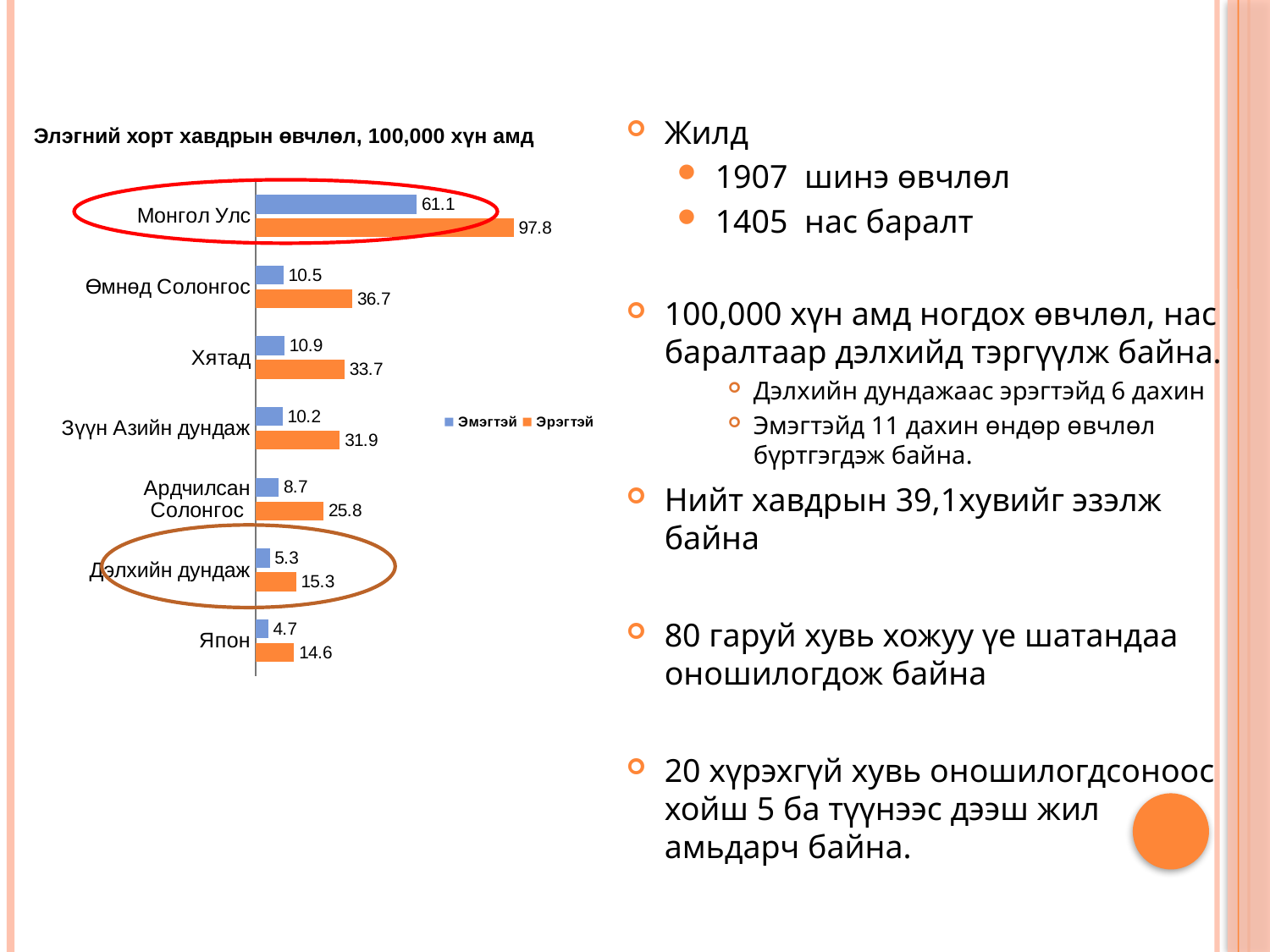
What is the Эрэгтэй value for Монгол Улс? 97.8 What is the title of the chart? Элэгний хорт хавдрын өвчлөл, 100,000 хүн амд Which category has the lowest Эмэгтэй value? Япон Which category has the highest Эрэгтэй value? Монгол Улс What is the Эмэгтэй value for Өмнөд Солонгос? 10.5 How many categories are shown on the chart? 7 How many series does the legend list? 2 What is the difference between the Эрэгтэй and Эмэгтэй values for Монгол Улс? 36.7 Which is larger, the Эрэгтэй value for Хятад or the Эрэгтэй value for Өмнөд Солонгос? Өмнөд Солонгос What is the Эрэгтэй value for Дэлхийн дундаж? 15.3 What kind of chart is shown on the slide? Bar chart What is the Эмэгтэй value for Япон? 4.7